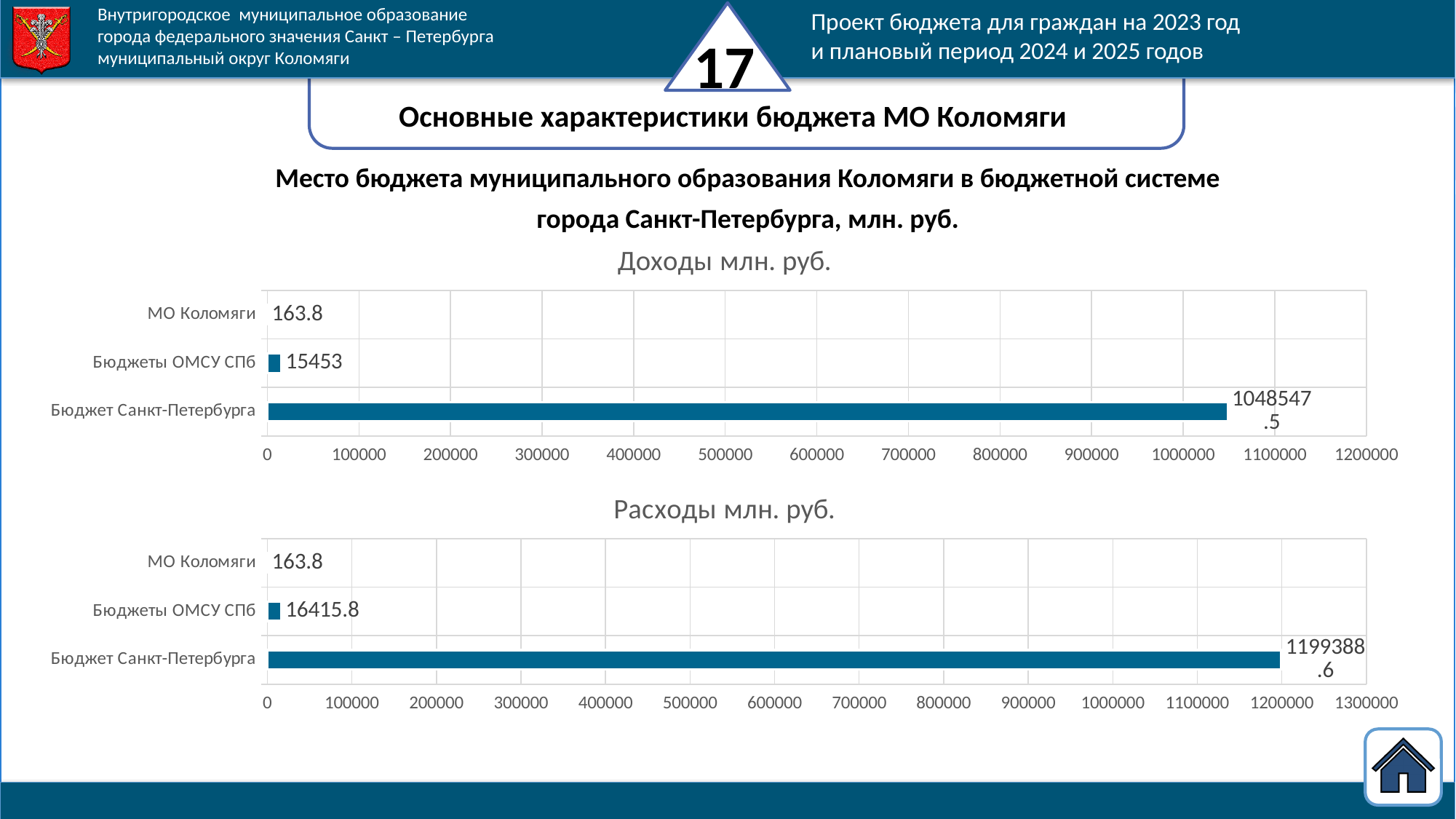
In the chart titled "Доходы млн. руб.", what is the value for Бюджеты ОМСУ СПб? 15453 In the chart titled "Расходы млн. руб.", what is the difference between the values for Бюджеты ОМСУ СПб and МО Коломяги? 16252 In the chart titled "Расходы млн. руб.", what is the value for Бюджеты ОМСУ СПб? 16415.8 In the chart titled "Доходы млн. руб.", what is the difference between the values for Бюджеты ОМСУ СПб and МО Коломяги? 15289.2 In the chart titled "Доходы млн. руб.", which category has the highest value? Бюджет Санкт-Петербурга How many categories are shown in the chart titled "Доходы млн. руб."? 3 In the chart titled "Расходы млн. руб.", what is the value for МО Коломяги? 163.8 In the chart titled "Доходы млн. руб.", what is the value for Бюджет Санкт-Петербурга? 1048547.5 Which is larger: the value for Бюджет Санкт-Петербурга in the chart titled "Доходы млн. руб." or in the chart titled "Расходы млн. руб."? Расходы млн. руб. In the chart titled "Расходы млн. руб.", which category has the lowest value? МО Коломяги What type of chart is the chart titled "Расходы млн. руб."? Bar chart In the chart titled "Расходы млн. руб.", what is the value for Бюджет Санкт-Петербурга? 1199388.6